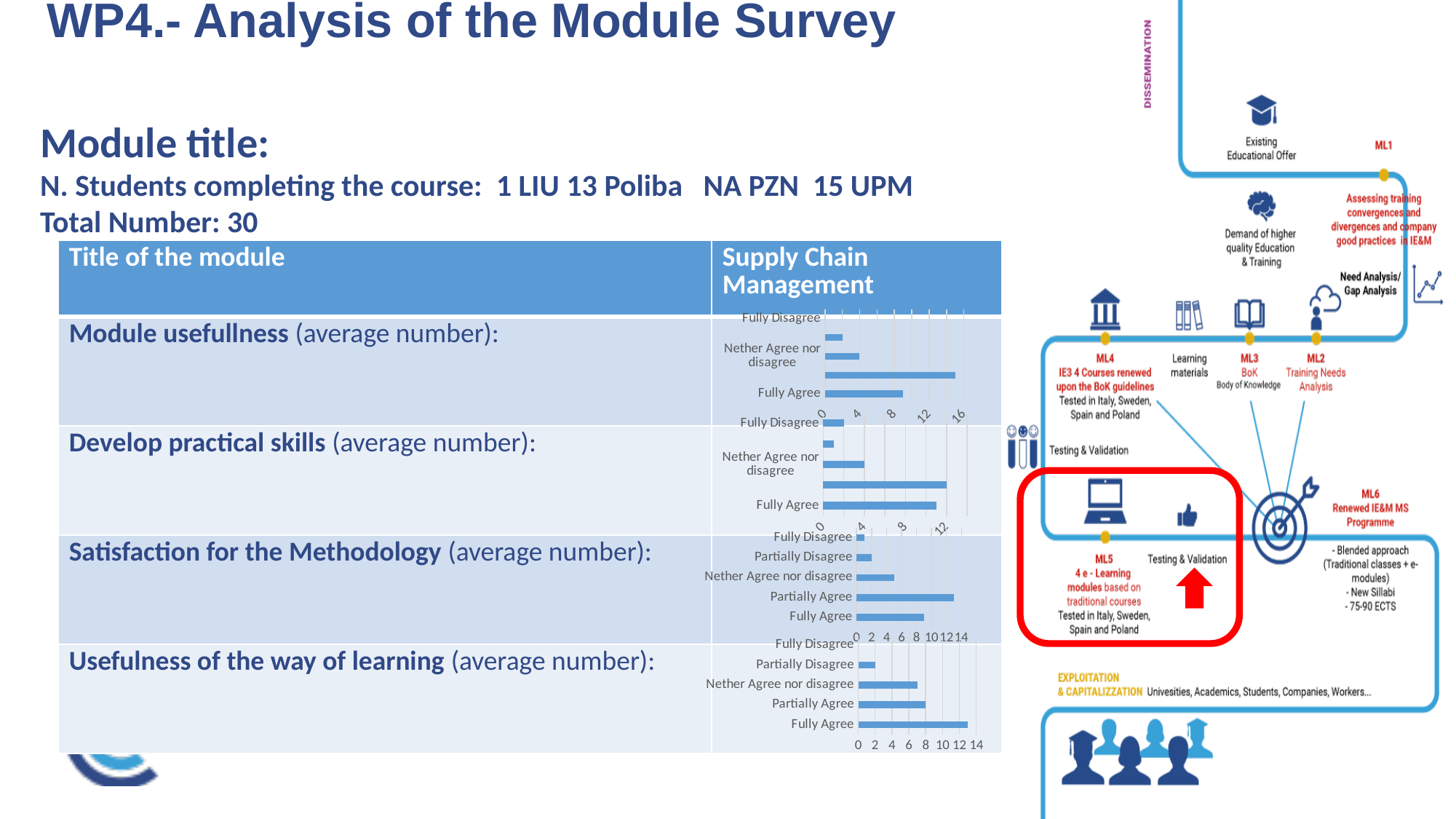
In the 'Satisfaction for the Methodology' chart, which category has the highest value? Partially Agree What kind of chart is used for the 'Satisfaction for the Methodology' row? bar chart In the 'Develop practical skills' chart, is the value for Fully Agree greater or less than 8? greater In the 'Usefulness of the way of learning' chart, which category has the lowest value? Fully Disagree How many charts are shown in the table on the slide? 4 In the 'Usefulness of the way of learning' chart, is the value for Fully Agree greater or less than 12? greater In the 'Usefulness of the way of learning' chart, which category has the highest value? Fully Agree In the 'Satisfaction for the Methodology' chart, which category has the lowest value? Fully Disagree In the 'Usefulness of the way of learning' chart, is the value for Partially Disagree greater or less than 4? less In the 'Satisfaction for the Methodology' chart, which is larger: Fully Agree or Nether Agree nor disagree? Fully Agree In the 'Satisfaction for the Methodology' chart, how many categories are plotted? 5